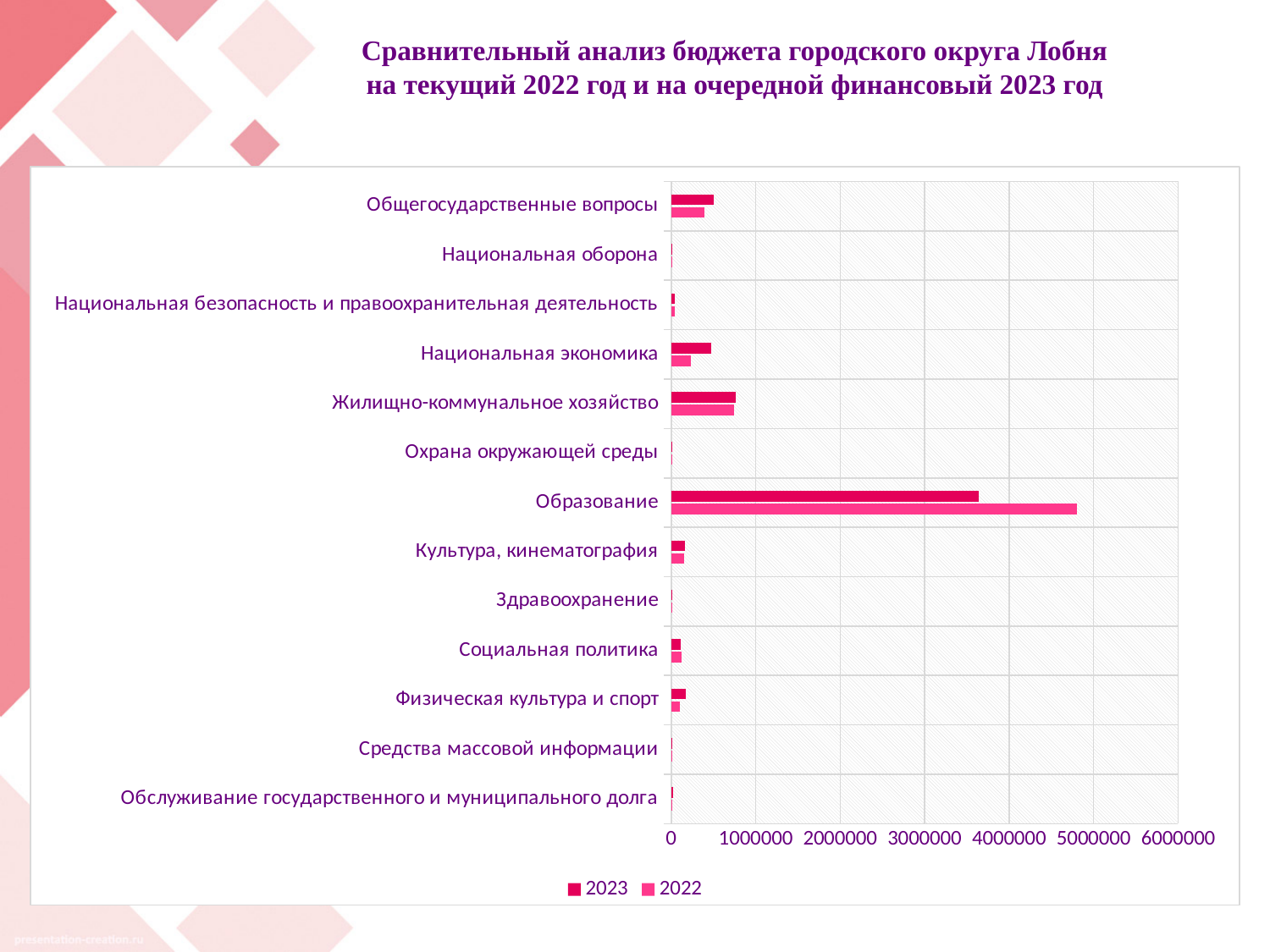
Is the 2023 value for Образование greater or less than 3000000? greater How many budget categories are plotted on the chart? 13 What kind of chart is shown on the slide? Bar chart Which category has the highest value for the 2022 series? Образование For Национальная экономика, which series has the larger value, 2022 or 2023? 2023 Which series are listed in the legend? 2023 and 2022 For Образование, which series has the larger value, 2022 or 2023? 2022 How many series does the legend list? 2 Is the 2022 value for Образование greater or less than 4000000? greater Is the 2023 value for Жилищно-коммунальное хозяйство greater or less than 1000000? less Which category has the highest value for the 2023 series? Образование What is the maximum value shown on the horizontal axis? 6000000